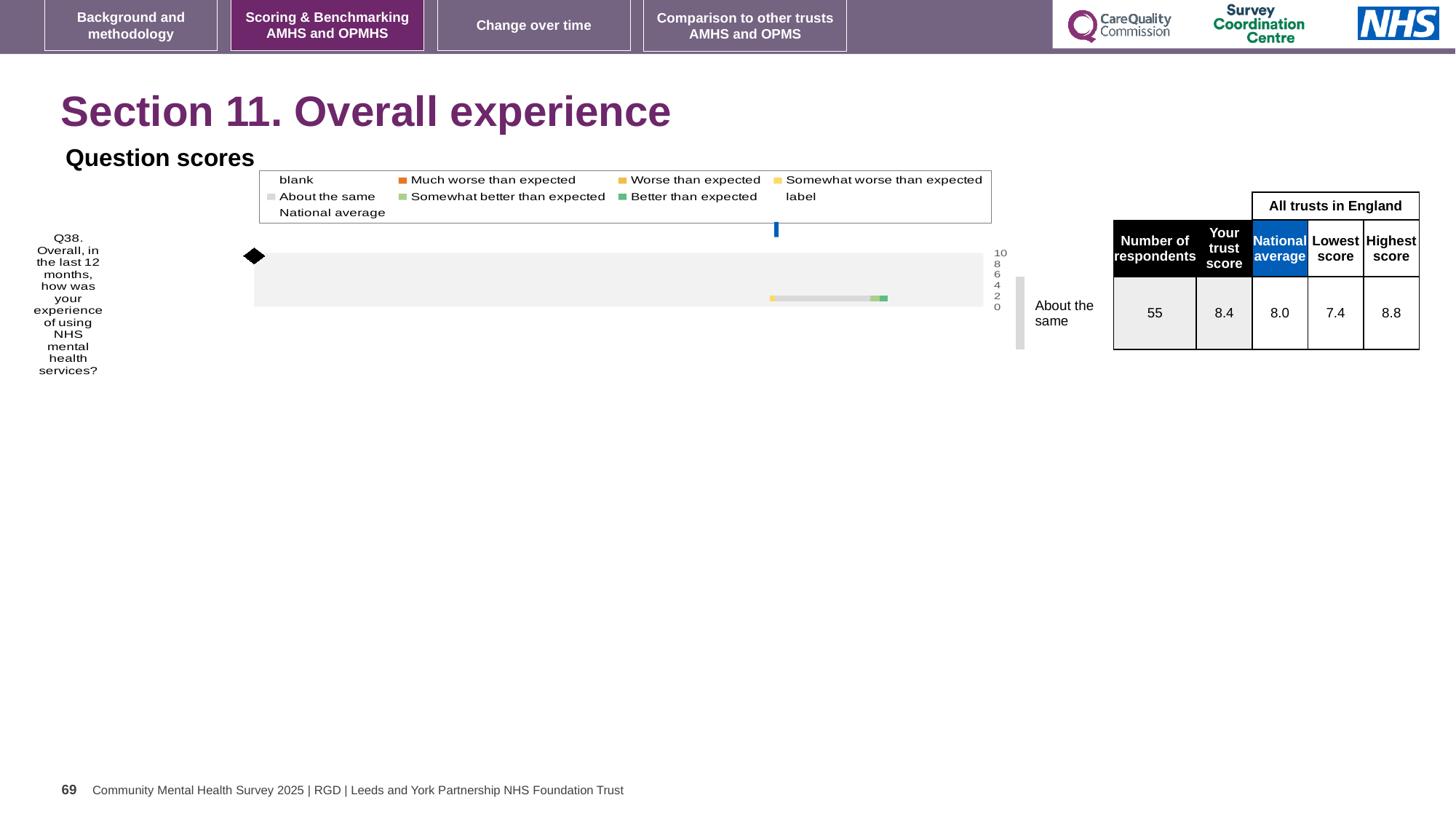
How many questions are plotted in the Question scores chart? 1 In the table beside the chart, what is the number of respondents for Q38? 55 What type of chart is used to show the question scores? bar chart What benchmark category is shown next to the bar for Q38 in the Question scores chart? About the same In the table beside the chart, what is the trust's score for Q38? 8.4 In the table beside the chart, what is the lowest score among all trusts in England for Q38? 7.4 In the table beside the chart, what is the highest score among all trusts in England for Q38? 8.8 For Q38, what is the difference between the highest and lowest scores among all trusts in England? 1.4 What is the highest value shown on the score axis of the Question scores chart? 10 For Q38, which is larger: the trust's score or the national average? the trust's score For Q38, how much higher is the trust's score than the national average? 0.4 In the table beside the chart, what is the national average score for Q38? 8.0